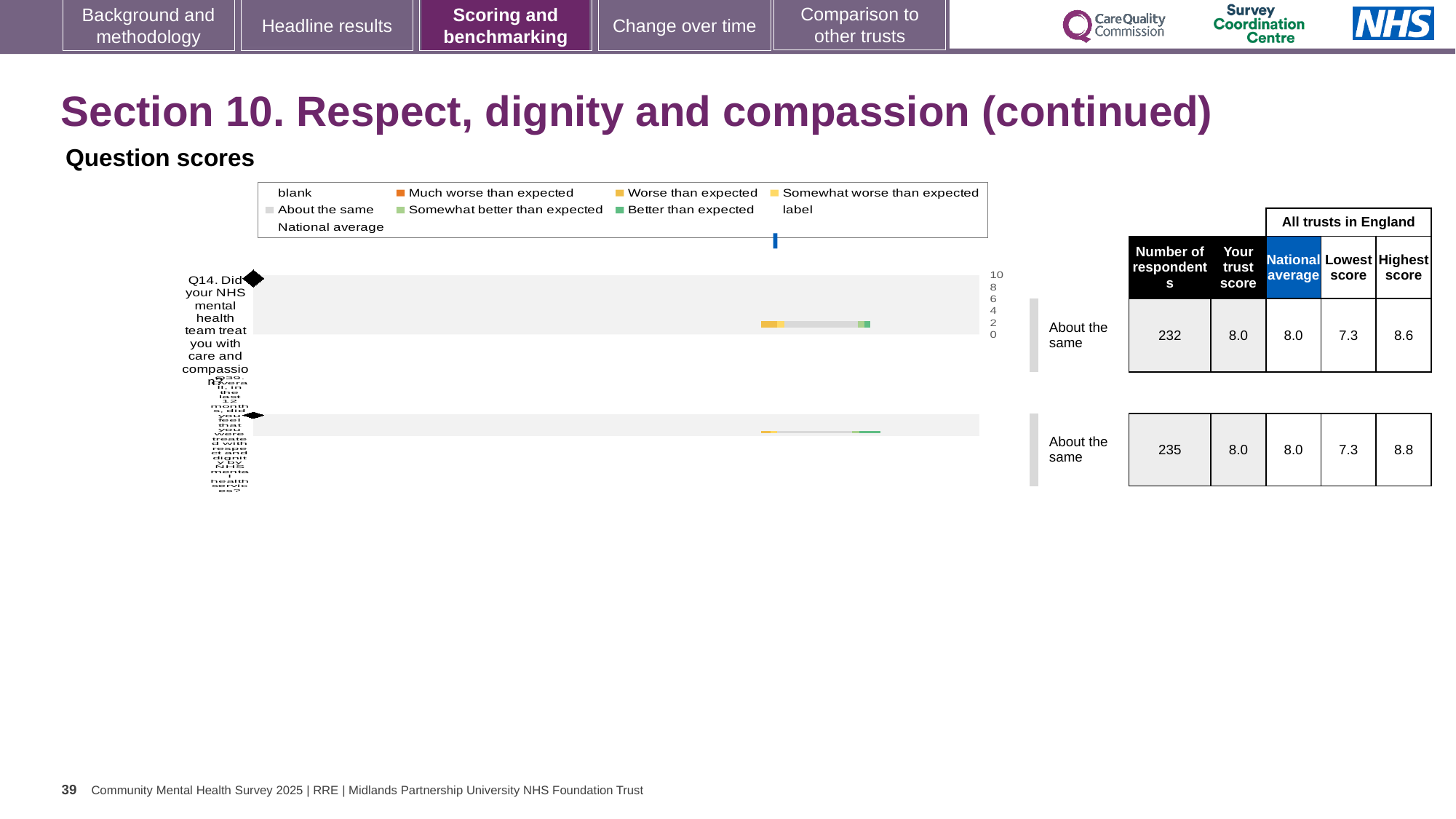
How many respondents are listed for Q39? 235 What benchmark category is shown for Q14? About the same How many entries does the chart legend list? 9 What is the heading above the chart? Question scores What is the trust score for Q14? 8.0 What is the highest score across all trusts in England for Q39? 8.8 How many questions (categories) are plotted in the chart? 2 Which question has the higher 'Highest score' value, Q14 or Q39? Q39 What kind of chart is shown on the slide? bar chart How many respondents are listed for Q14? 232 What is the highest value shown on the chart's score axis? 10 What is the difference between the highest score and the lowest score for Q39? 1.5